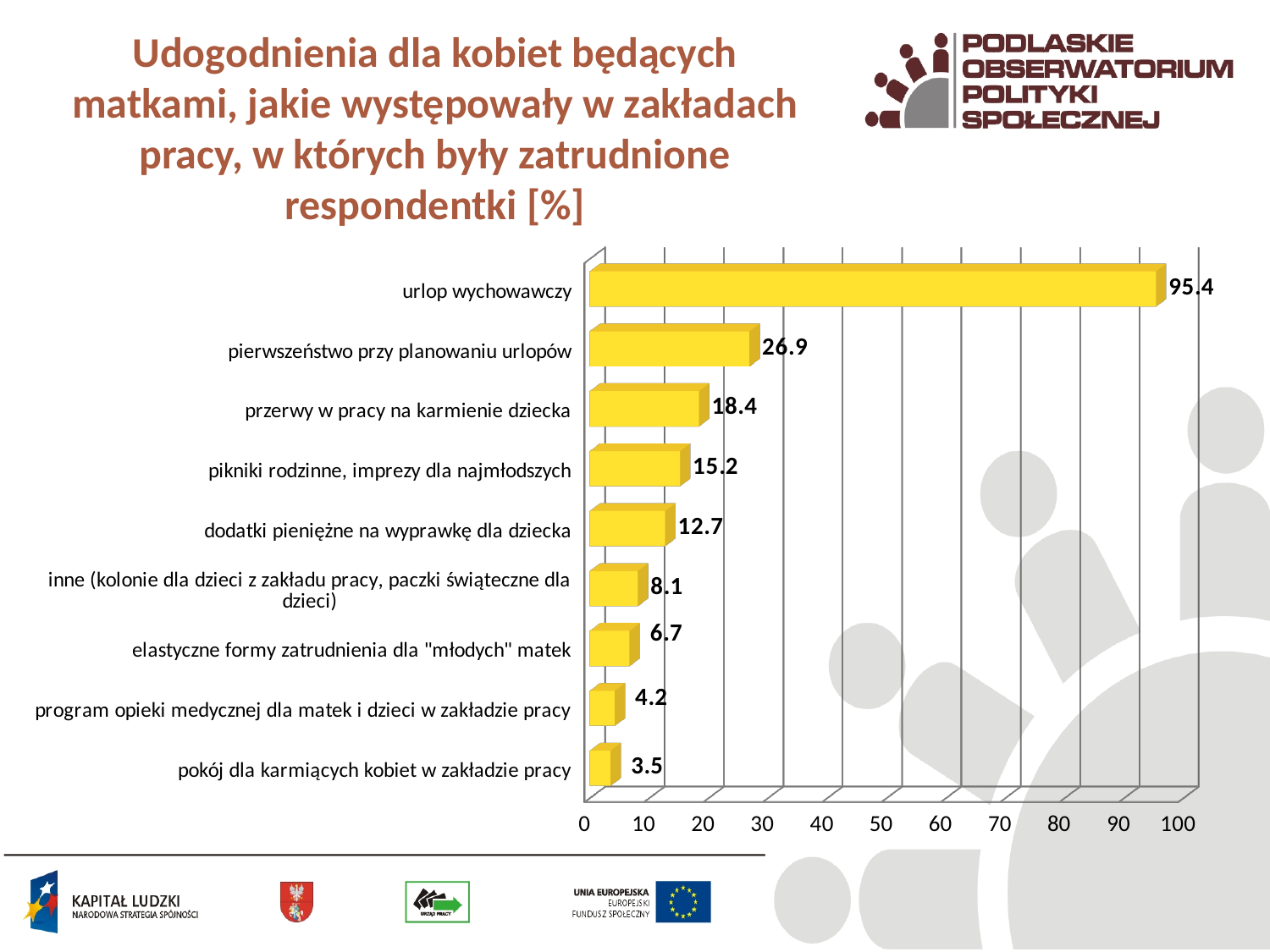
What is the value for "pokój dla karmiących kobiet w zakładzie pracy"? 3.5 What is the value for "przerwy w pracy na karmienie dziecka"? 18.4 Which is larger: the value for "pikniki rodzinne, imprezy dla najmłodszych" or for "dodatki pieniężne na wyprawkę dla dziecka"? pikniki rodzinne, imprezy dla najmłodszych What is the highest tick value shown on the horizontal axis? 100 What is the value for "elastyczne formy zatrudnienia dla "młodych" matek"? 6.7 Is the value for "pierwszeństwo przy planowaniu urlopów" greater or less than 20? greater Which category has the highest value? urlop wychowawczy Which category has the lowest value? pokój dla karmiących kobiet w zakładzie pracy What kind of chart is shown on the slide? bar chart What is the difference between the values for "urlop wychowawczy" and "pierwszeństwo przy planowaniu urlopów"? 68.5 How many categories are shown in the chart? 9 What is the value for "urlop wychowawczy"? 95.4